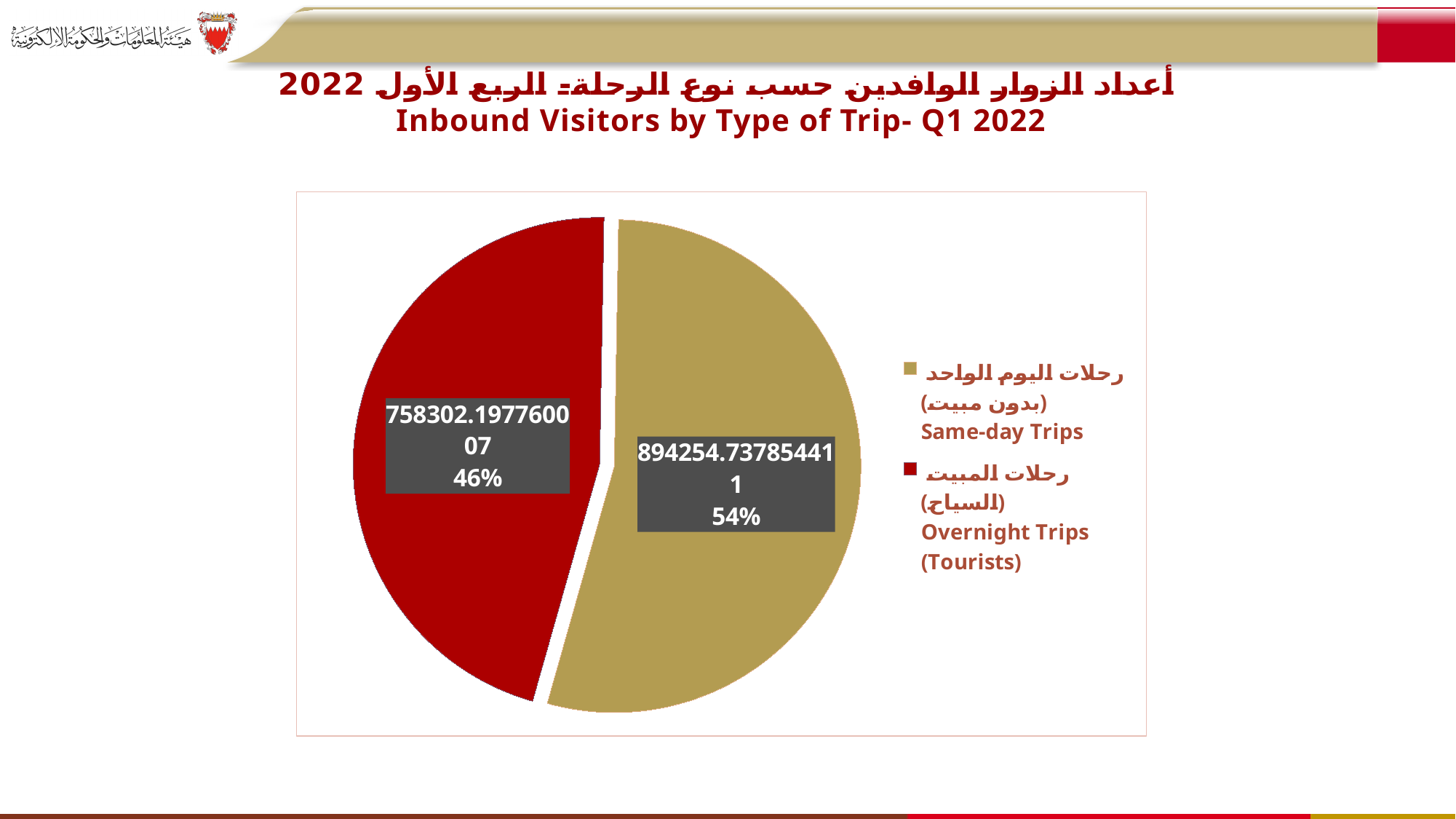
How many slices does the pie chart have? 2 What is the value shown for Overnight Trips (Tourists)? 758302.197760007 Which type of trip has the smallest share of the pie? Overnight Trips (Tourists) What is the title of the chart in English? Inbound Visitors by Type of Trip- Q1 2022 What share of the pie is Overnight Trips (Tourists)? 46% Which is larger, the share for Same-day Trips or the share for Overnight Trips (Tourists)? Same-day Trips What is the value shown for Same-day Trips? 894254.737854411 What colour is the slice for Overnight Trips (Tourists)? Red What share of the pie is Same-day Trips? 54% How many entries does the legend list? 2 What kind of chart is shown on the slide? Pie chart Which type of trip has the largest share of the pie? Same-day Trips